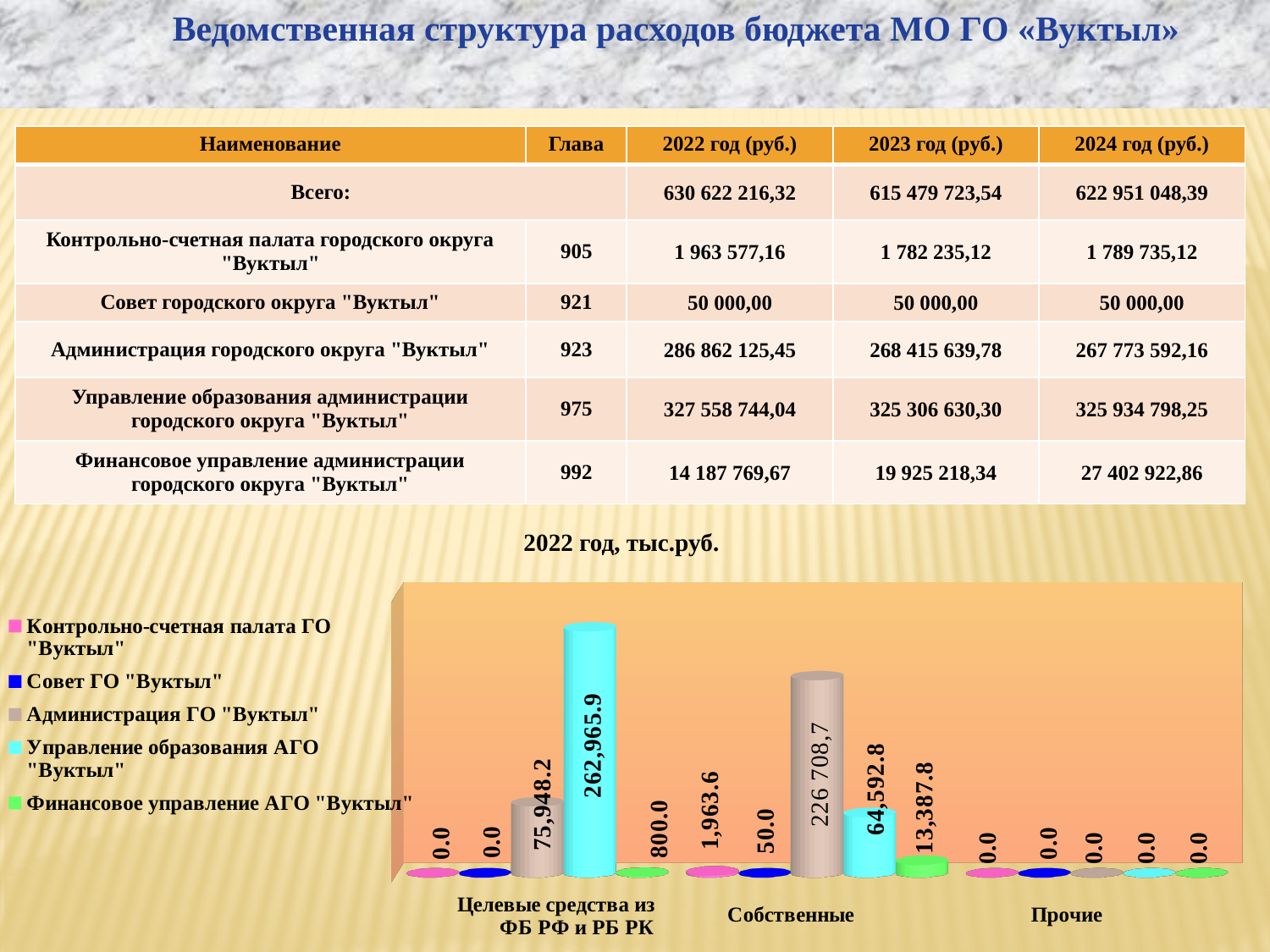
What is the value for Управление образования АГО "Вуктыл" in the Целевые средства из ФБ РФ и РБ РК category? 262,965.9 Which is larger: the value for Администрация ГО "Вуктыл" in Целевые средства из ФБ РФ и РБ РК or in Собственные? Собственные What is the value for Администрация ГО "Вуктыл" in the Собственные category? 226 708,7 What is the value for Контрольно-счетная палата ГО "Вуктыл" in the Собственные category? 1,963.6 What kind of chart is shown on the slide? bar chart What is the value for Финансовое управление АГО "Вуктыл" in the Собственные category? 13,387.8 What is the value for Совет ГО "Вуктыл" in the Собственные category? 50.0 Which series has the highest value in the Собственные category? Администрация ГО "Вуктыл" What is the title of the chart? 2022 год, тыс.руб. How many categories are shown on the x axis of the chart? 3 How many series does the chart legend list? 5 Which series has the highest value in the Целевые средства из ФБ РФ и РБ РК category? Управление образования АГО "Вуктыл"